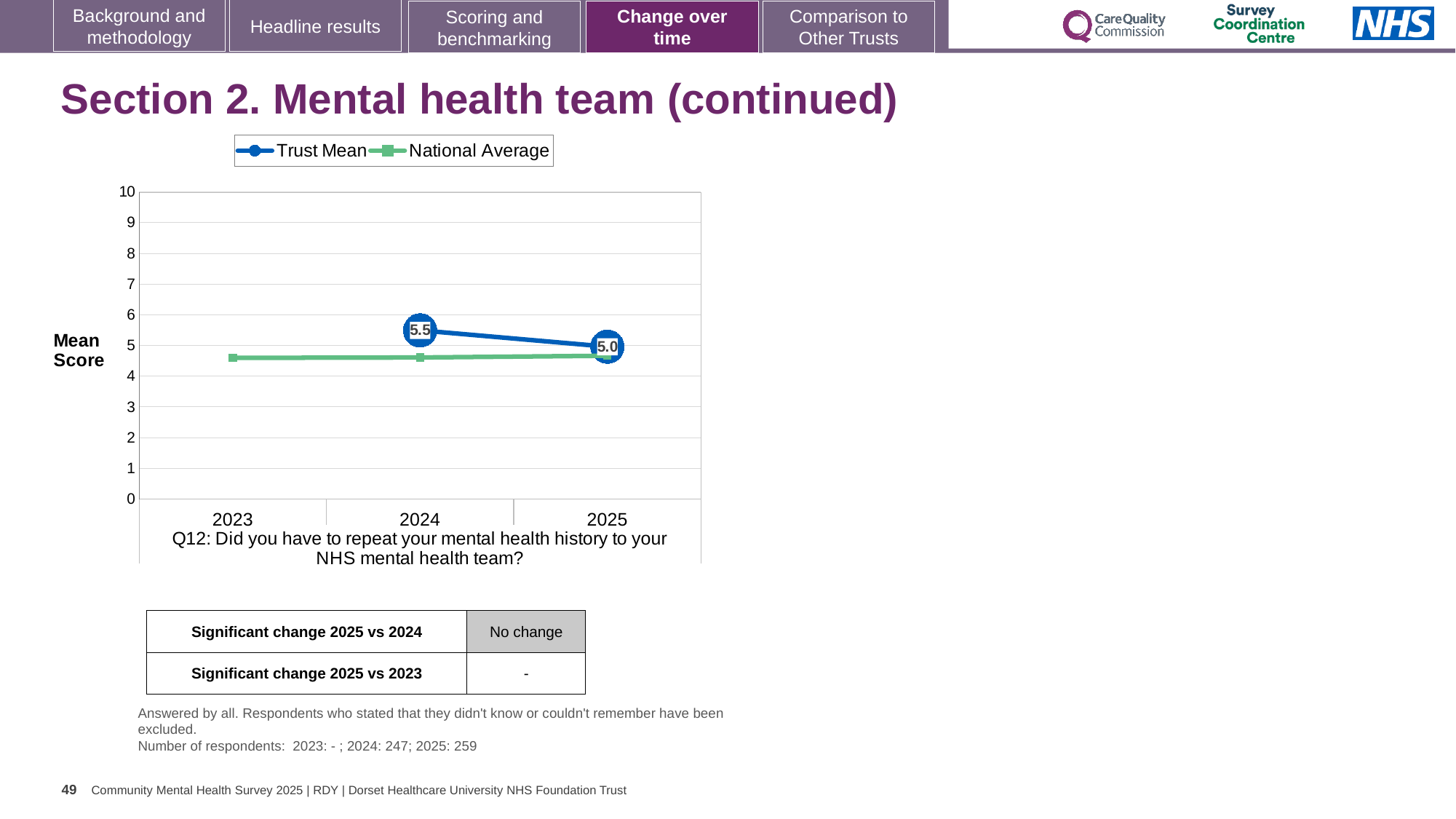
How many years are shown on the x axis? 3 What is the label on the y axis of the chart? Mean Score In 2024, which is higher, the Trust Mean or the National Average? Trust Mean What kind of chart is shown on the slide? line chart By how much did the Trust Mean change between 2024 and 2025? 0.5 Which year has the higher Trust Mean, 2024 or 2025? 2024 Is the National Average value for 2023 greater or less than 5? less What is the Trust Mean value for 2025? 5.0 What are the two series named in the legend? Trust Mean and National Average What is the Trust Mean value for 2024? 5.5 How many series does the legend list? 2 Does the Trust Mean rise or fall from 2024 to 2025? fall